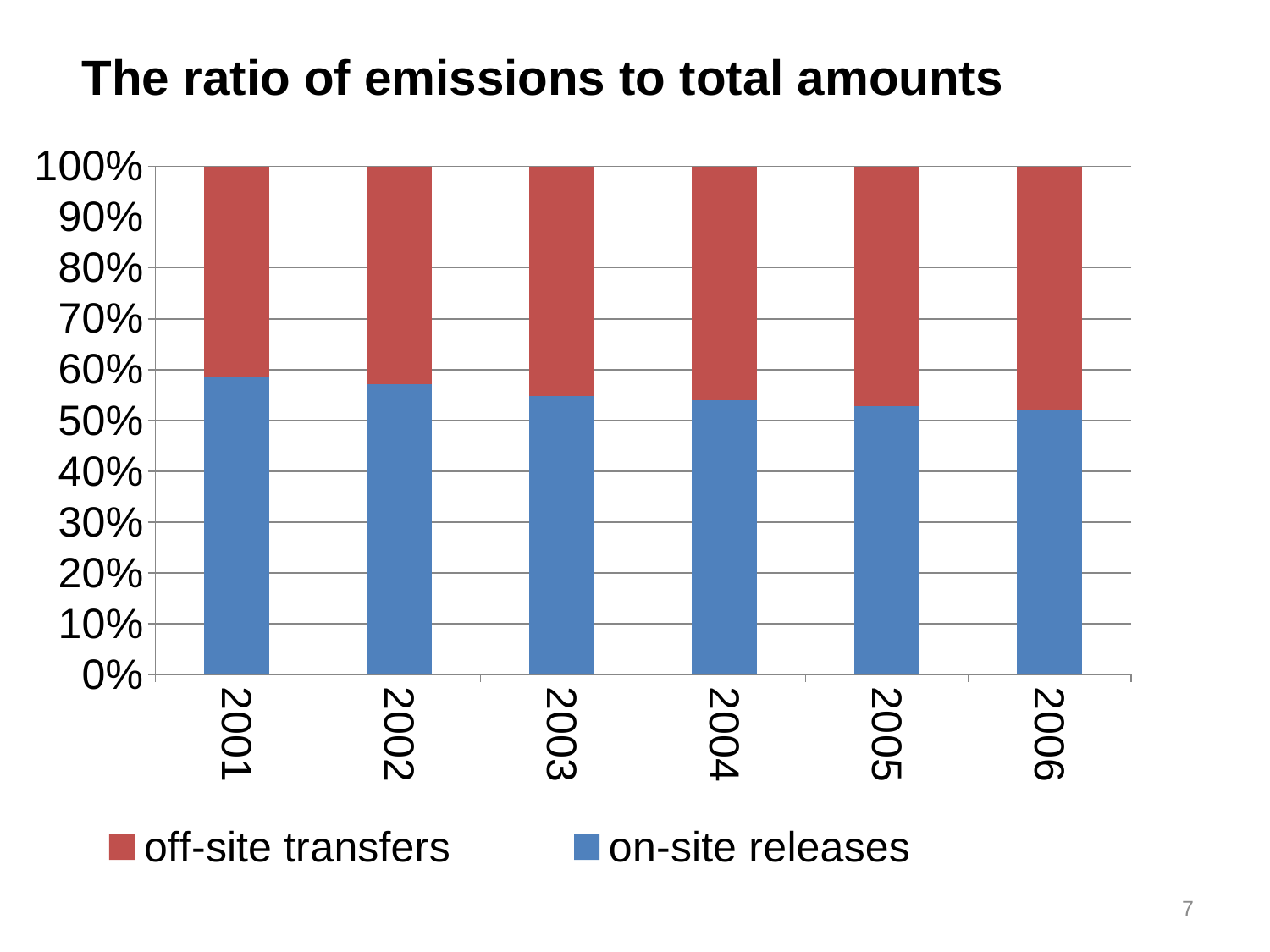
Is the value for on-site releases in 2001 greater or less than 50%? greater Does the share of on-site releases rise or fall from 2001 to 2006? fall How many years are shown on the x axis of the chart? 6 How many series does the legend list? 2 Is the value for off-site transfers in 2001 greater or less than 50%? less Which year has the larger share of on-site releases, 2001 or 2006? 2001 Is the value for on-site releases in 2006 greater or less than 60%? less What is the title of the chart? The ratio of emissions to total amounts What is the total of each stacked bar in the chart? 100% What kind of chart is shown on the slide? stacked bar chart Which colour represents on-site releases in the chart? blue